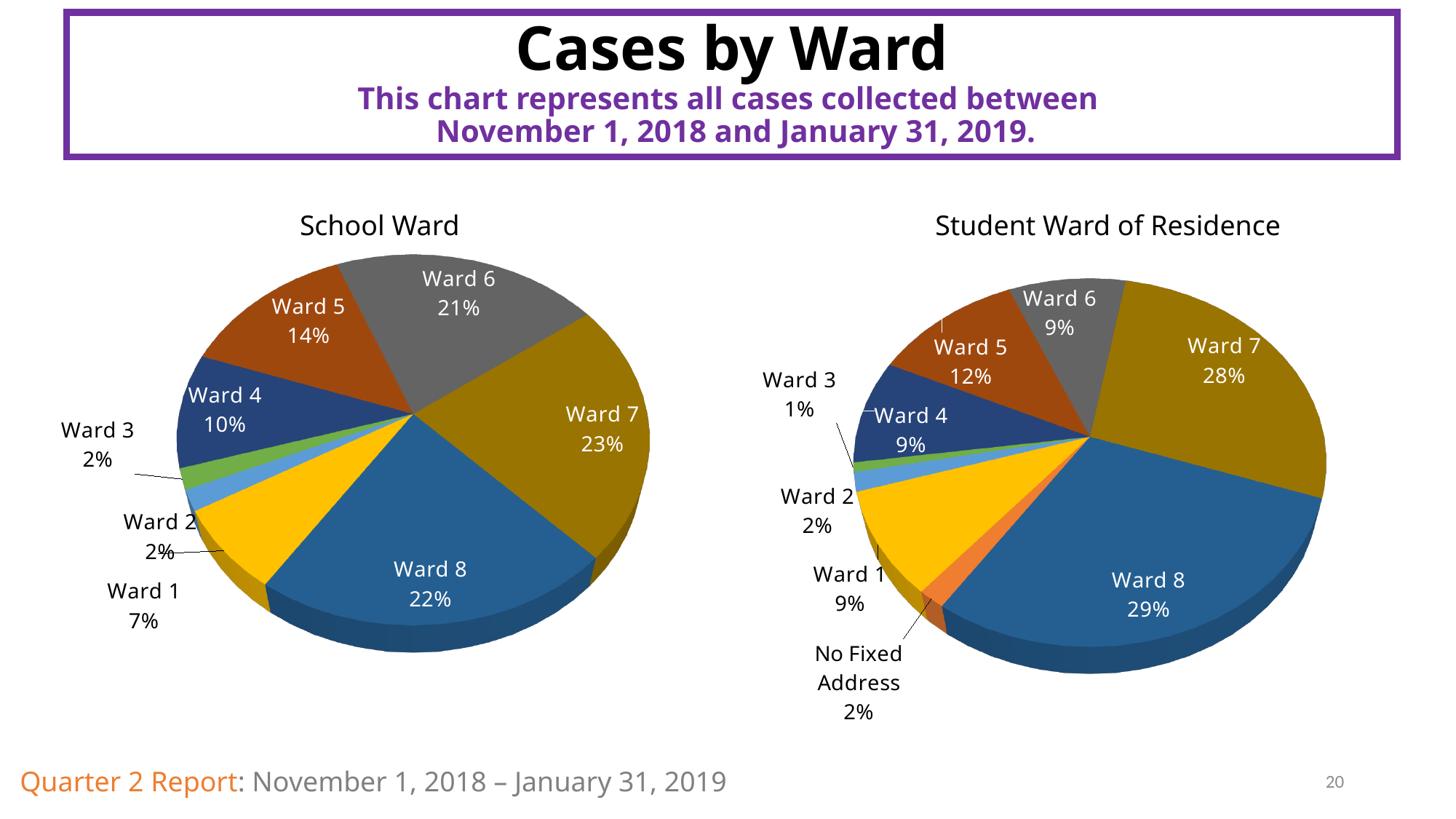
What is the title of the chart on the right side of the slide? Student Ward of Residence In the School Ward chart, what is the difference between the shares of Ward 5 and Ward 4? 4% In the Student Ward of Residence chart, which ward has the smallest share? Ward 3 In the School Ward chart, what share of cases is Ward 7? 23% In the Student Ward of Residence chart, what share of cases is No Fixed Address? 2% In the Student Ward of Residence chart, what share of cases is Ward 8? 29% How many slices does the Student Ward of Residence pie chart have? 9 What type of chart is the School Ward chart? Pie chart In the Student Ward of Residence chart, which is larger, Ward 7 or Ward 5? Ward 7 In the School Ward chart, which ward has the smallest share? Ward 2 and Ward 3 (2% each) In the Student Ward of Residence chart, which category has the largest share? Ward 8 In the School Ward chart, which ward has the largest share? Ward 7